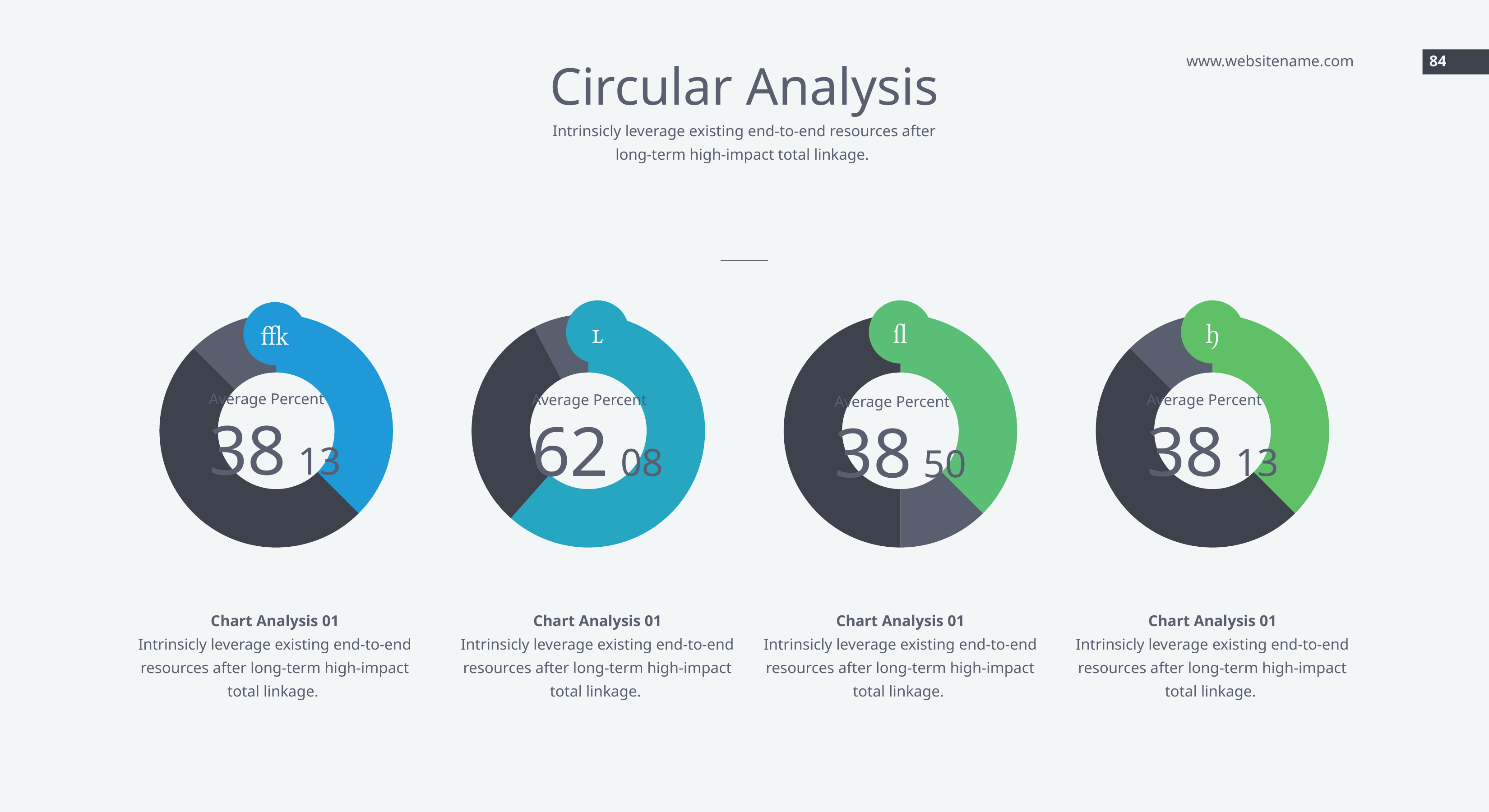
What colour is the highlighted segment of the leftmost donut chart? Blue What large number is printed in the centre of the leftmost donut chart? 38 Which donut chart shows the highest large centre number? Second from the left (62) Is the large centre number of the second donut chart from the left larger than that of the rightmost donut chart? Yes, 62 is larger than 38 What label text appears above the number in the centre of each donut chart? Average Percent What is the difference between the large centre numbers of the second donut chart and the leftmost donut chart? 24 How many segments does each donut chart have? 3 How many donut charts are shown on the slide? 4 What kind of chart is used for each of the four figures on the slide? Donut chart What smaller number is printed beside the 38 in the third donut chart from the left? 50 What large number is printed in the centre of the second donut chart from the left? 62